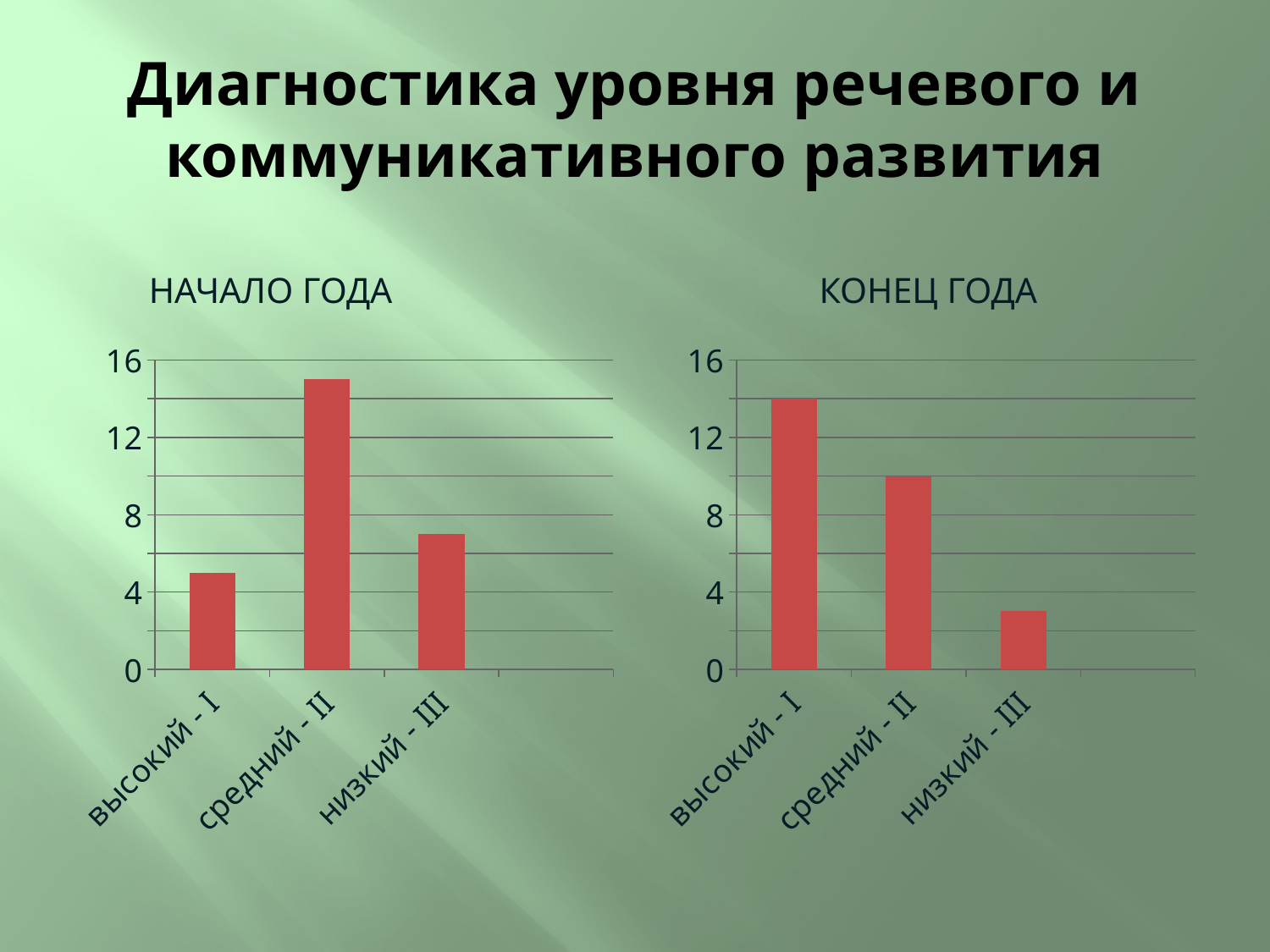
On the НАЧАЛО ГОДА chart, which category has the lowest bar? высокий - I On the КОНЕЦ ГОДА chart, which category has the lowest bar? низкий - III How many categories are shown on the КОНЕЦ ГОДА chart? 3 On the НАЧАЛО ГОДА chart, is the value for низкий - III greater or less than 8? less What type of chart is the НАЧАЛО ГОДА chart? bar chart On the НАЧАЛО ГОДА chart, which category has the highest bar? средний - II On the КОНЕЦ ГОДА chart, is the value for высокий - I greater or less than 12? greater On the НАЧАЛО ГОДА chart, is the value for средний - II greater or less than 12? greater On the КОНЕЦ ГОДА chart, which category has the highest bar? высокий - I On the НАЧАЛО ГОДА chart, which is larger, the bar for средний - II or the bar for низкий - III? средний - II On the КОНЕЦ ГОДА chart, which is larger, the bar for высокий - I or the bar for средний - II? высокий - I